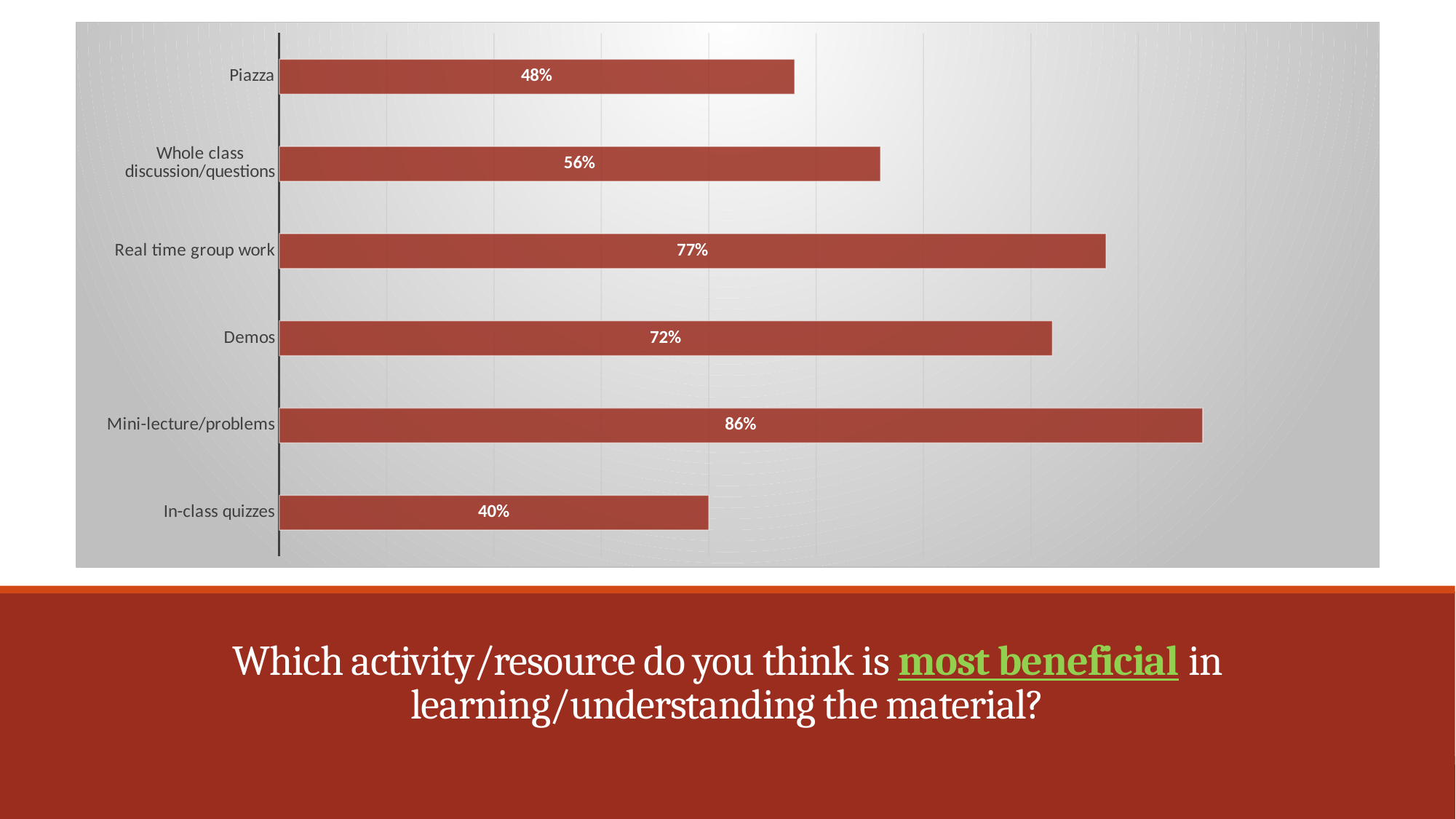
What percentage is shown for Piazza? 48% What percentage is shown for Real time group work? 77% What question does the text below the chart ask? Which activity/resource do you think is most beneficial in learning/understanding the material? What percentage is shown for In-class quizzes? 40% Which has a higher percentage, Whole class discussion/questions or Piazza? Whole class discussion/questions Which activity/resource has the lowest percentage? In-class quizzes How many activities/resources are shown in the chart? 6 What kind of chart is shown on the slide? Bar chart What is the difference between the percentages for Mini-lecture/problems and In-class quizzes? 46% Which activity/resource has the highest percentage? Mini-lecture/problems What percentage is shown for Mini-lecture/problems? 86% What is the difference between the percentages for Real time group work and Demos? 5%